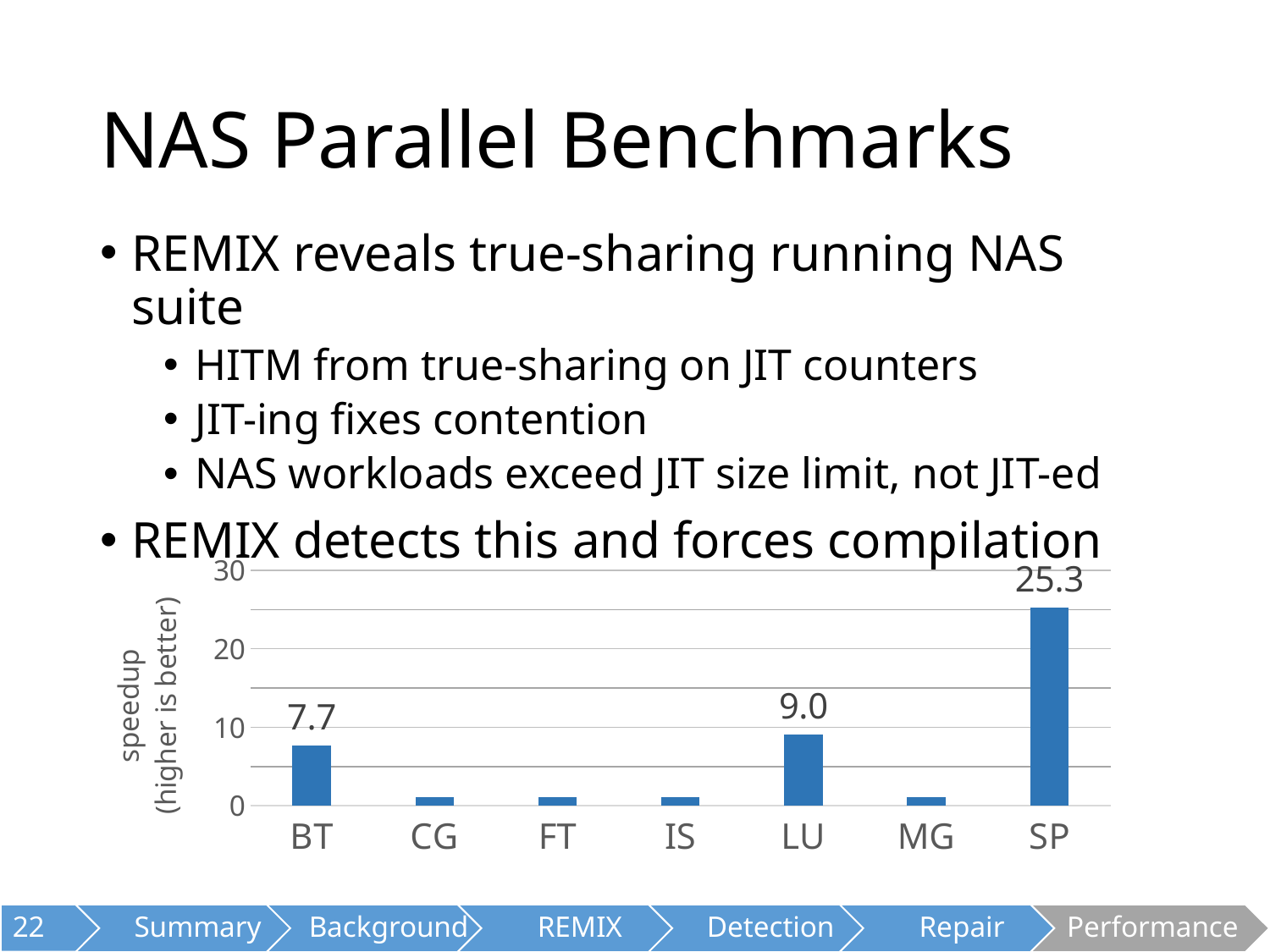
What is the speedup value for BT? 7.7 What is the difference between the speedup for SP and the speedup for BT? 17.6 Which benchmark has the highest speedup? SP What is the label on the y axis of the chart? speedup (higher is better) What is the difference between the speedup for LU and the speedup for BT? 1.3 Is the speedup for SP greater or less than 20? greater What is the speedup value for SP? 25.3 How many benchmarks are shown on the x axis of the chart? 7 What kind of chart is shown on the slide? bar chart Is the speedup for CG greater or less than 10? less Which has a larger speedup, LU or BT? LU What is the speedup value for LU? 9.0